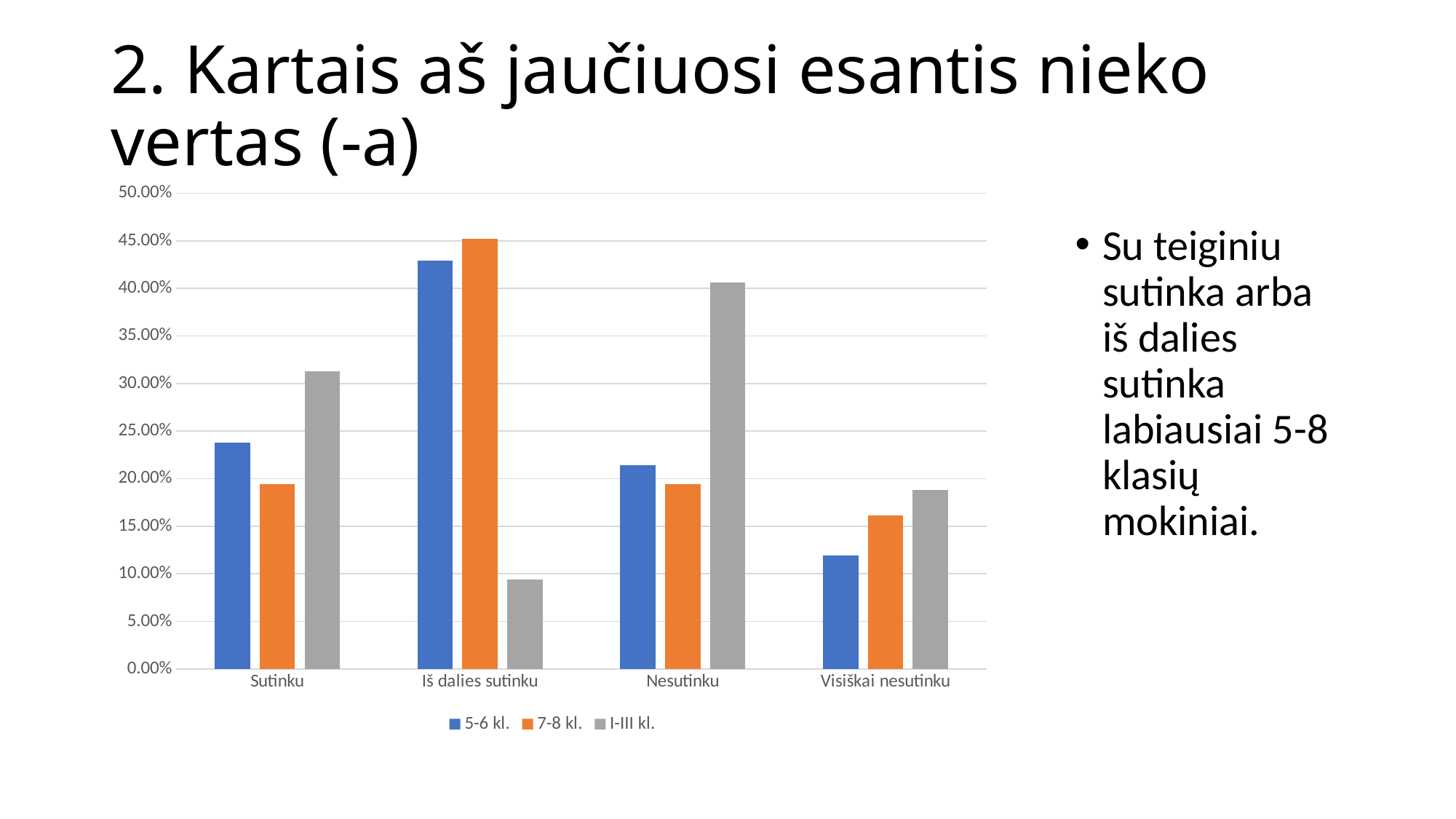
Is the value for 5-6 kl. in the Iš dalies sutinku category greater or less than 40.00%? greater Which category has the highest value for the 7-8 kl. series? Iš dalies sutinku How many categories are shown on the x axis? 4 In the Sutinku category, which series has the larger value: 5-6 kl. or I-III kl.? I-III kl. In the Visiškai nesutinku category, which series has the larger value: 5-6 kl. or 7-8 kl.? 7-8 kl. What are the three series listed in the legend? 5-6 kl., 7-8 kl., I-III kl. How many series does the legend list? 3 Which category has the lowest value for the I-III kl. series? Iš dalies sutinku Which category has the highest value for the I-III kl. series? Nesutinku Is the value for I-III kl. in the Iš dalies sutinku category greater or less than 15.00%? less What kind of chart is shown on the slide? bar chart Which category has the lowest value for the 5-6 kl. series? Visiškai nesutinku